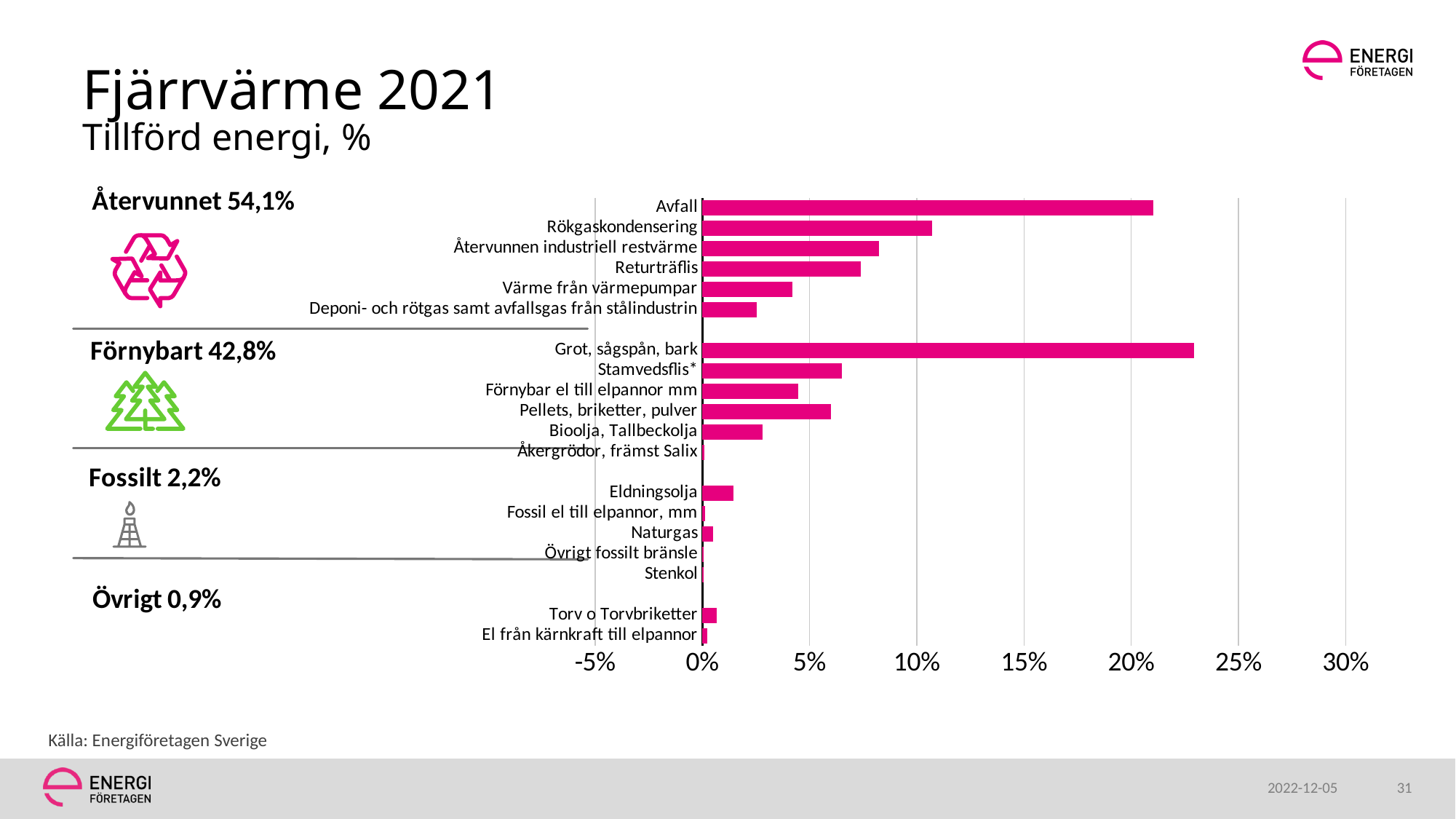
What is the highest value shown on the chart's horizontal axis? 30% Is the value for Pellets, briketter, pulver greater or less than 5%? greater How many categories (bars) are plotted in the chart? 19 Is the value for Värme från värmepumpar greater or less than 5%? less Is the value for Returträflis greater or less than 10%? less Which is larger, the value for Avfall or the value for Rökgaskondensering? Avfall What kind of chart is shown on the slide? bar chart What is the title of the slide containing the chart? Fjärrvärme 2021 Which category has the highest value in the chart? Grot, sågspån, bark Which is larger, the value for Eldningsolja or the value for Naturgas? Eldningsolja